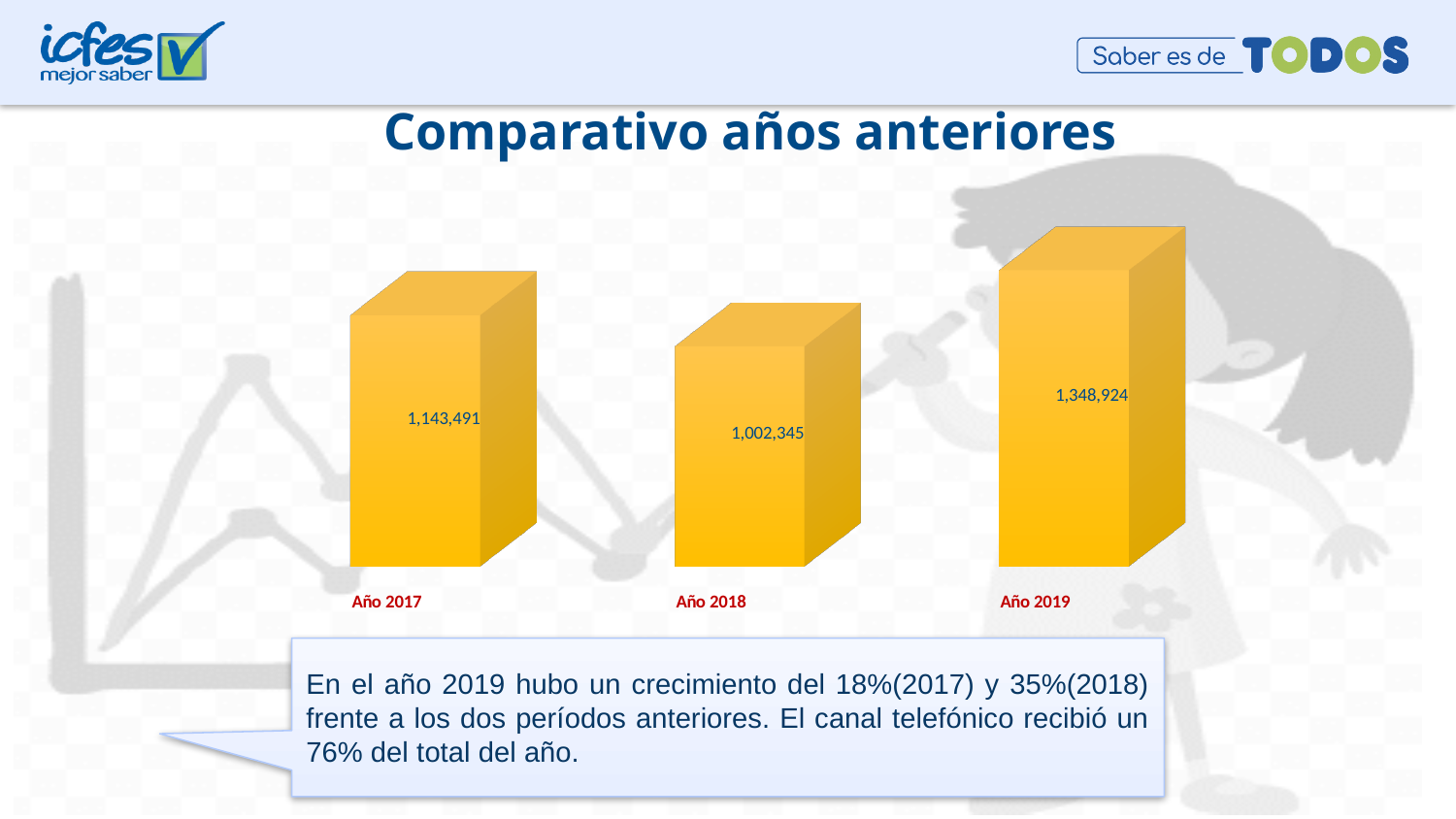
What is the value for Año 2019? 1,348,924 What is the difference between the values for Año 2019 and Año 2017? 205,433 How many years are shown in the chart? 3 Which year has the lowest value? Año 2018 What kind of chart is shown on the slide? Bar chart What is the value for Año 2017? 1,143,491 What is the title of the chart? Comparativo años anteriores What is the value for Año 2018? 1,002,345 Which is larger, the value for Año 2017 or Año 2018? Año 2017 Which year has the highest value? Año 2019 What is the difference between the values for Año 2017 and Año 2018? 141,146 What is the difference between the values for Año 2019 and Año 2018? 346,579